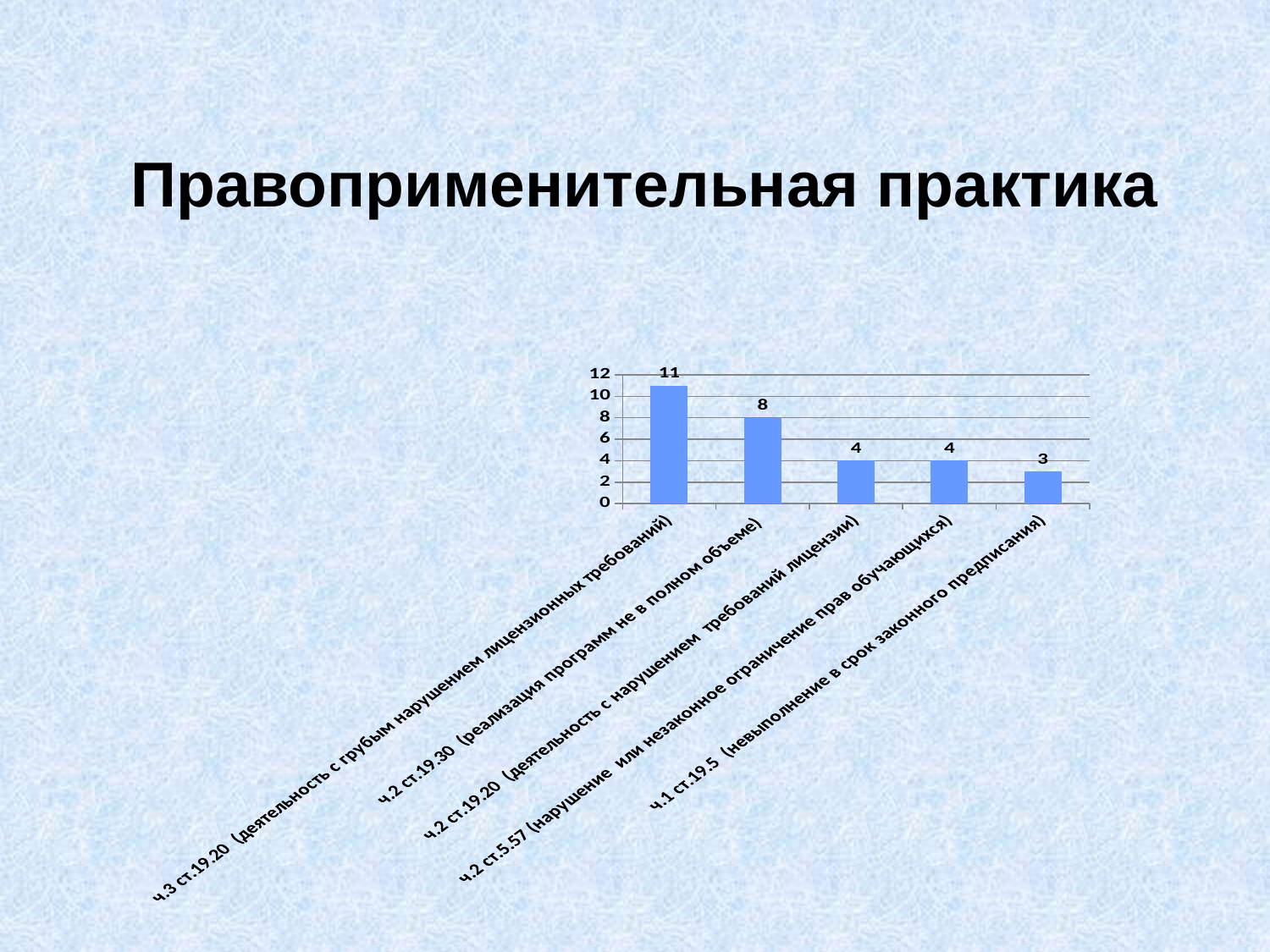
What kind of chart is shown on the slide? bar chart Which category has the highest value? ч.3 ст.19.20 (деятельность с грубым нарушением лицензионных требований) Do the values rise or fall from left to right along the x axis? fall What is the title of the slide? Правоприменительная практика What value is shown for ч.3 ст.19.20 (деятельность с грубым нарушением лицензионных требований)? 11 How many categories are shown in the chart? 5 What value is shown for ч.2 ст.5.57 (нарушение или незаконное ограничение прав обучающихся)? 4 Which category has the lowest value? ч.1 ст.19.5 (невыполнение в срок законного предписания) What value is shown for ч.1 ст.19.5 (невыполнение в срок законного предписания)? 3 What value is shown for ч.2 ст.19.30 (реализация программ не в полном объеме)? 8 What is the difference between the values for ч.3 ст.19.20 and ч.2 ст.19.30? 3 Which is larger: the value for ч.2 ст.19.30 or the value for ч.2 ст.19.20? ч.2 ст.19.30